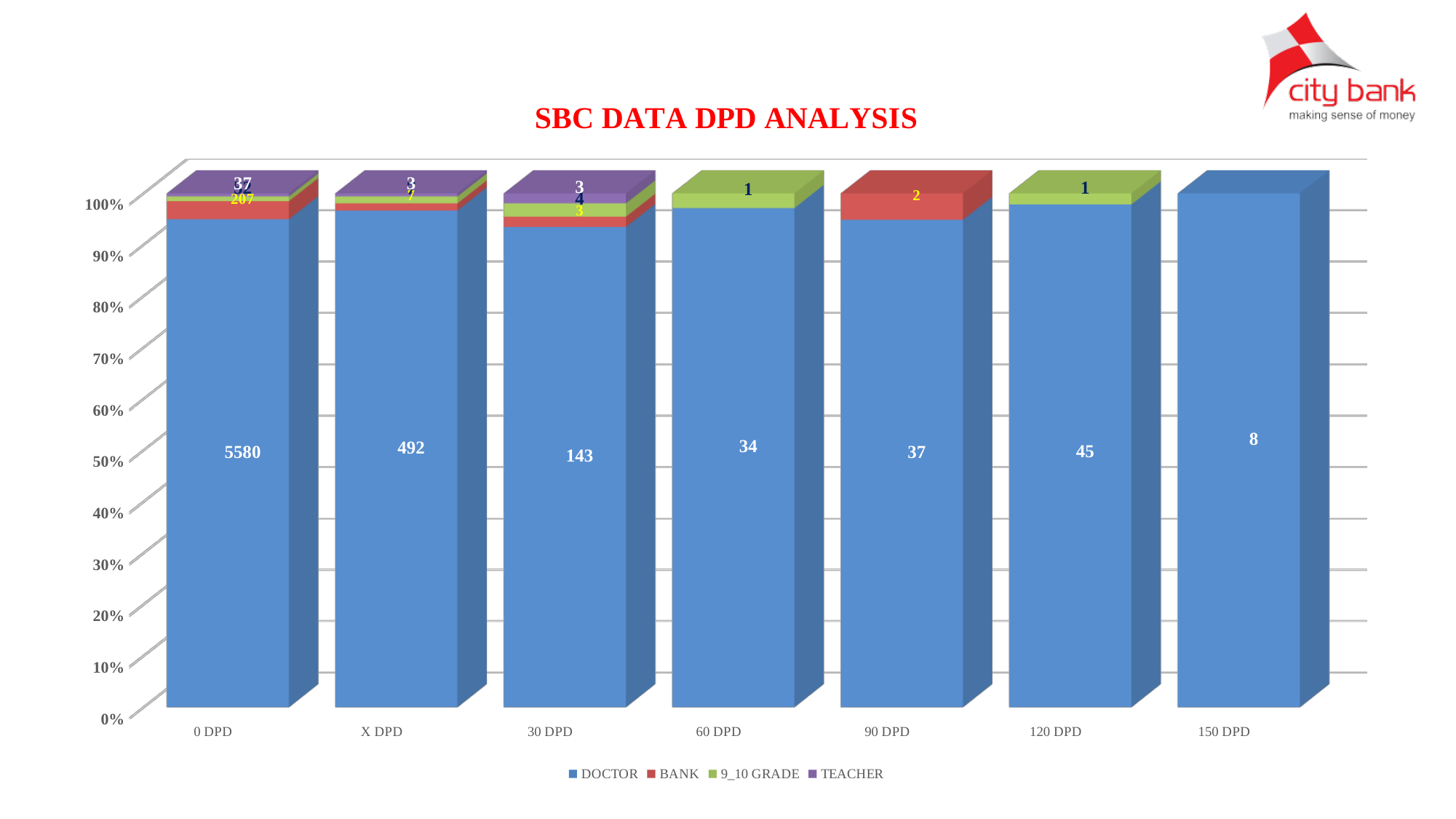
How many DPD categories are shown on the x axis? 7 What kind of chart is shown on the slide? Stacked bar chart What is the BANK value for 90 DPD? 2 Which is larger, the DOCTOR value for 60 DPD or for 120 DPD? 120 DPD What is the BANK value for 0 DPD? 207 How many series does the legend list? 4 What is the DOCTOR value for X DPD? 492 What is the DOCTOR value for 0 DPD? 5580 What is the difference between the DOCTOR values for 120 DPD and 90 DPD? 8 Which DPD category has the lowest DOCTOR value? 150 DPD What is the DOCTOR value for 30 DPD? 143 What is the 9_10 GRADE value for 60 DPD? 1